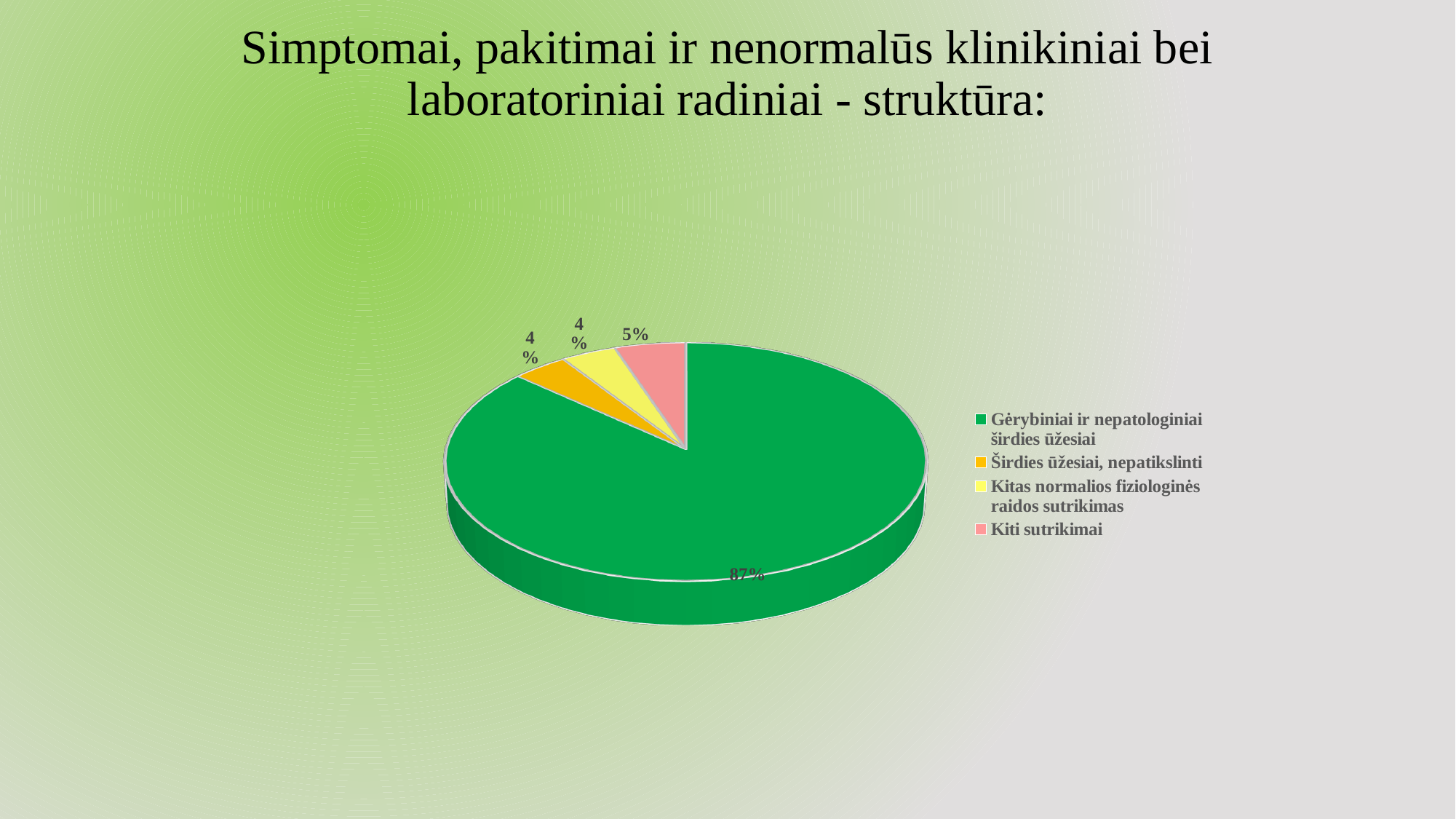
What share of the pie is labelled for "Gėrybiniai ir nepatologiniai širdies ūžesiai"? 87% How many entries does the legend list? 4 What share of the pie is labelled for "Kitas normalios fiziologinės raidos sutrikimas"? 4% What share of the pie is labelled for "Širdies ūžesiai, nepatikslinti"? 4% What colour is the slice for "Kiti sutrikimai"? Pink Which category has the largest slice of the pie? Gėrybiniai ir nepatologiniai širdies ūžesiai How many slices does the pie chart have? 4 What kind of chart is shown on the slide? Pie chart Which is larger: the slice for "Kiti sutrikimai" or the slice for "Širdies ūžesiai, nepatikslinti"? Kiti sutrikimai What is the difference in percentage points between the "Gėrybiniai ir nepatologiniai širdies ūžesiai" slice and the "Kiti sutrikimai" slice? 82 percentage points What colour is the slice for "Širdies ūžesiai, nepatikslinti"? Orange